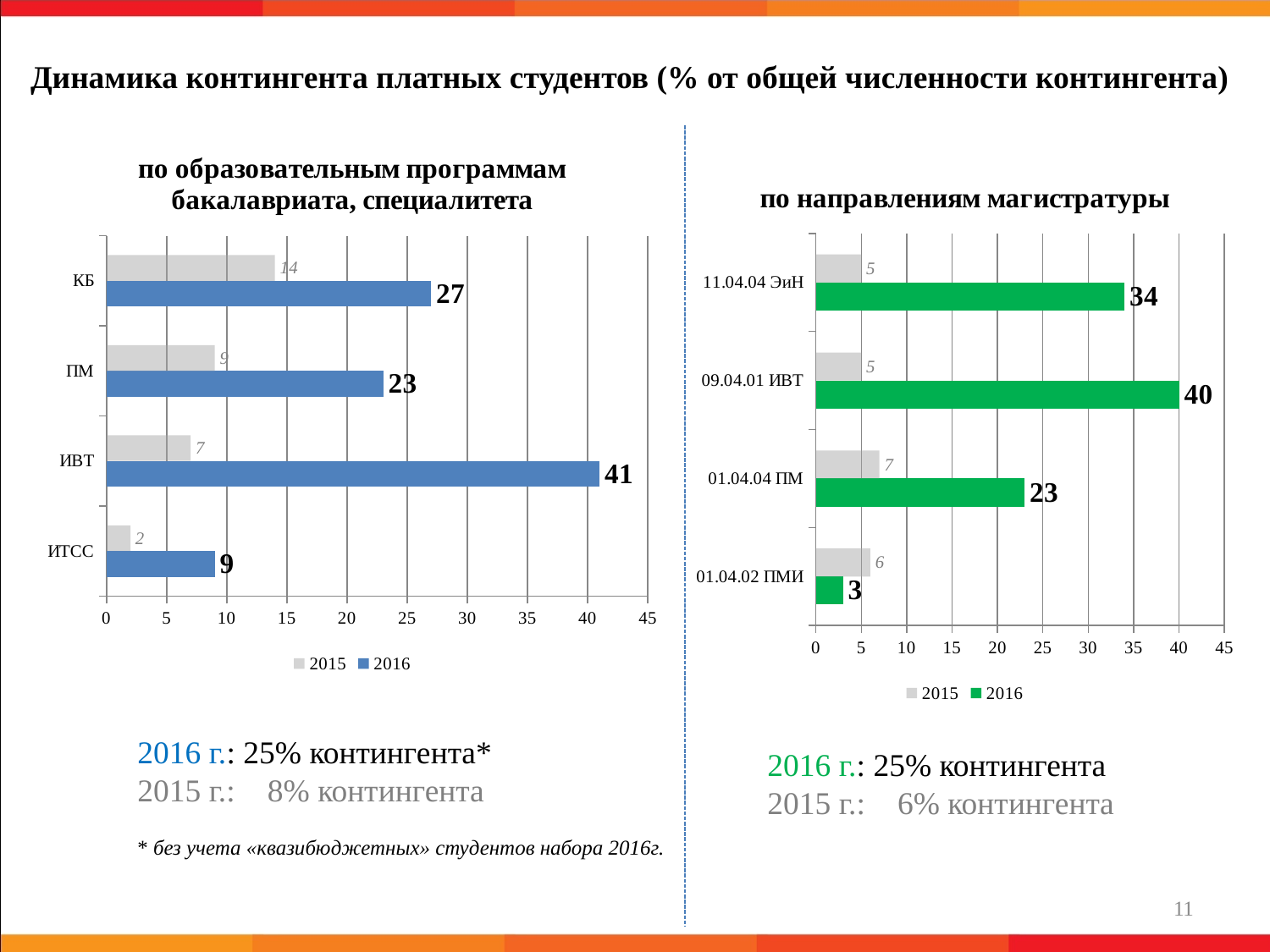
In the right chart (по направлениям магистратуры), which category has the highest 2016 value? 09.04.01 ИВТ In the left chart (по образовательным программам бакалавриата, специалитета), which category has the lowest 2016 value? ИТСС In the right chart (по направлениям магистратуры), what is the difference between the 2016 values for 11.04.04 ЭиН and 01.04.04 ПМ? 11 How many series does the legend of the right chart (по направлениям магистратуры) list? 2 In the left chart (по образовательным программам бакалавриата, специалитета), what is the 2016 value for ИВТ? 41 In the left chart (по образовательным программам бакалавриата, специалитета), what is the 2015 value for КБ? 14 In the left chart (по образовательным программам бакалавриата, специалитета), how many categories are shown? 4 In the right chart (по направлениям магистратуры), what is the 2015 value for 01.04.04 ПМ? 7 In the left chart (по образовательным программам бакалавриата, специалитета), what is the difference between the 2016 and 2015 values for ПМ? 14 In the right chart (по направлениям магистратуры), what is the 2016 value for 09.04.01 ИВТ? 40 What type of chart is the left chart (по образовательным программам бакалавриата, специалитета)? Bar chart In the right chart (по направлениям магистратуры), which is larger for 01.04.02 ПМИ: the 2015 value or the 2016 value? 2015